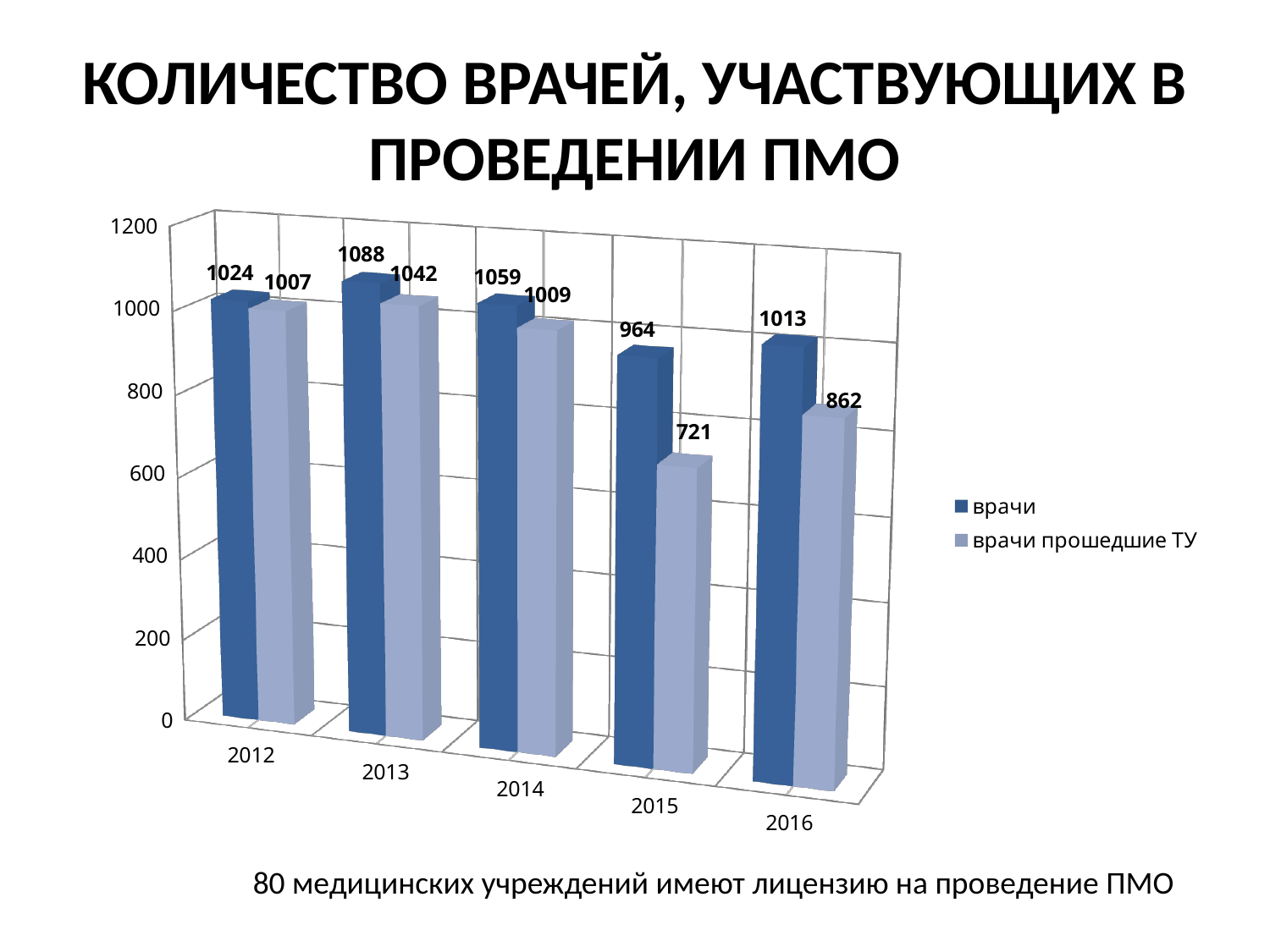
Which year has the highest value for "врачи"? 2013 What is the difference between "врачи" and "врачи прошедшие ТУ" in 2015? 243 How many series does the legend list? 2 Is the value for "врачи прошедшие ТУ" in 2015 greater or less than 800? less Which is larger: "врачи прошедшие ТУ" in 2012 or in 2016? 2012 What kind of chart is shown on the slide? bar chart What is the value for "врачи" in 2016? 1013 What is the value for "врачи прошедшие ТУ" in 2015? 721 Which year has the lowest value for "врачи прошедшие ТУ"? 2015 How many years are shown on the x axis? 5 What is the value for "врачи" in 2013? 1088 What is the title of the chart on the slide? КОЛИЧЕСТВО ВРАЧЕЙ, УЧАСТВУЮЩИХ В ПРОВЕДЕНИИ ПМО